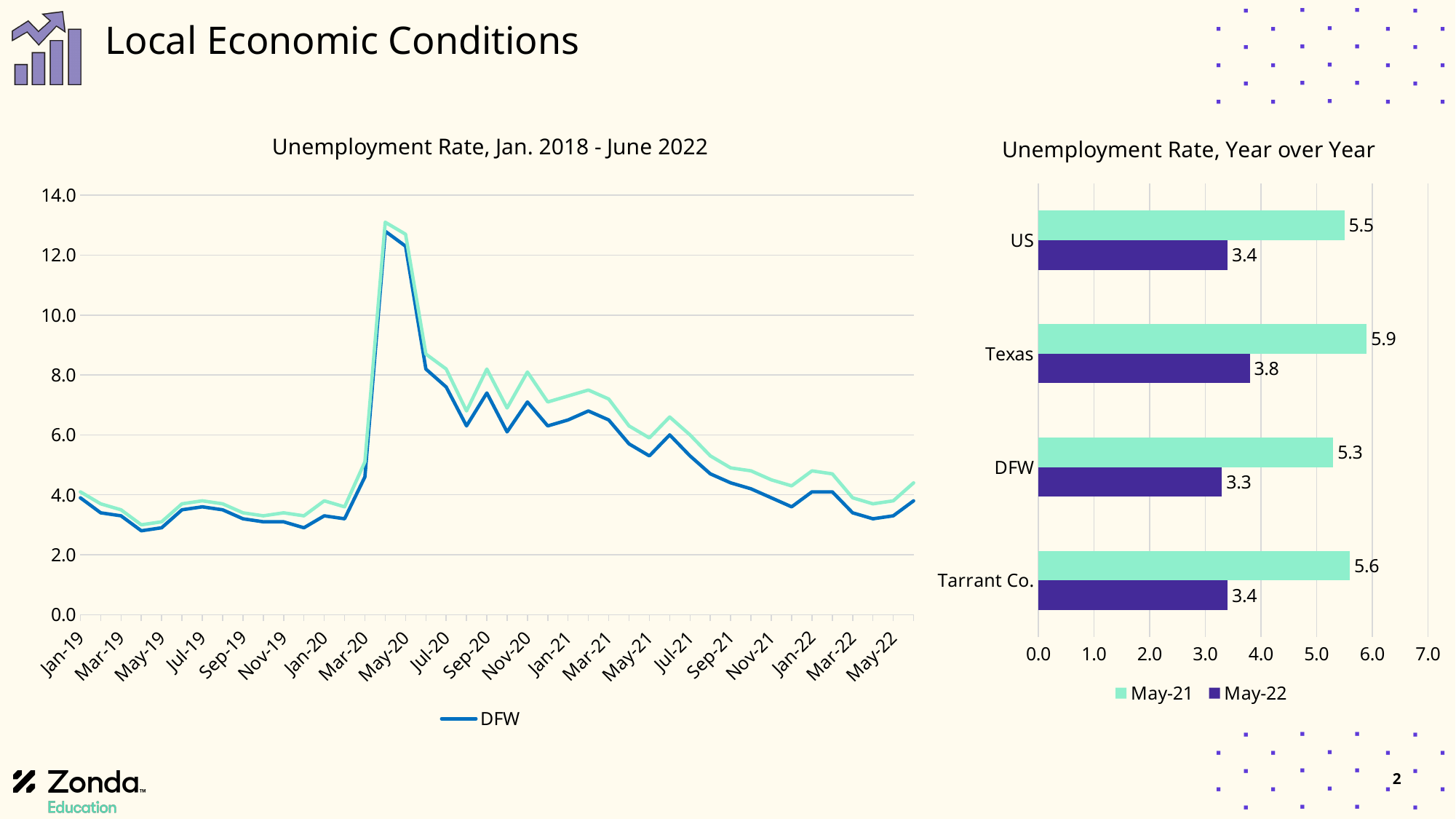
In the 'Unemployment Rate, Year over Year' chart, what is the May-22 value for Texas? 3.8 In the 'Unemployment Rate, Year over Year' chart, which is larger: the May-21 value for DFW or the May-21 value for Tarrant Co.? Tarrant Co. What kind of chart is the 'Unemployment Rate, Year over Year' chart? Bar chart In the 'Unemployment Rate, Year over Year' chart, which category has the highest May-21 value? Texas How many series does the legend of the 'Unemployment Rate, Year over Year' chart list? 2 In the 'Unemployment Rate, Year over Year' chart, what is the difference between the May-21 and May-22 values for the US? 2.1 What kind of chart is the 'Unemployment Rate, Jan. 2018 - June 2022' chart? Line chart In the 'Unemployment Rate, Year over Year' chart, which category has the lowest May-22 value? DFW In the 'Unemployment Rate, Jan. 2018 - June 2022' chart, is the peak DFW value in 2020 greater or less than 12.0? greater In the 'Unemployment Rate, Year over Year' chart, what is the May-21 value for Tarrant Co.? 5.6 How many categories are shown in the 'Unemployment Rate, Year over Year' chart? 4 In the 'Unemployment Rate, Year over Year' chart, what is the May-22 value for DFW? 3.3